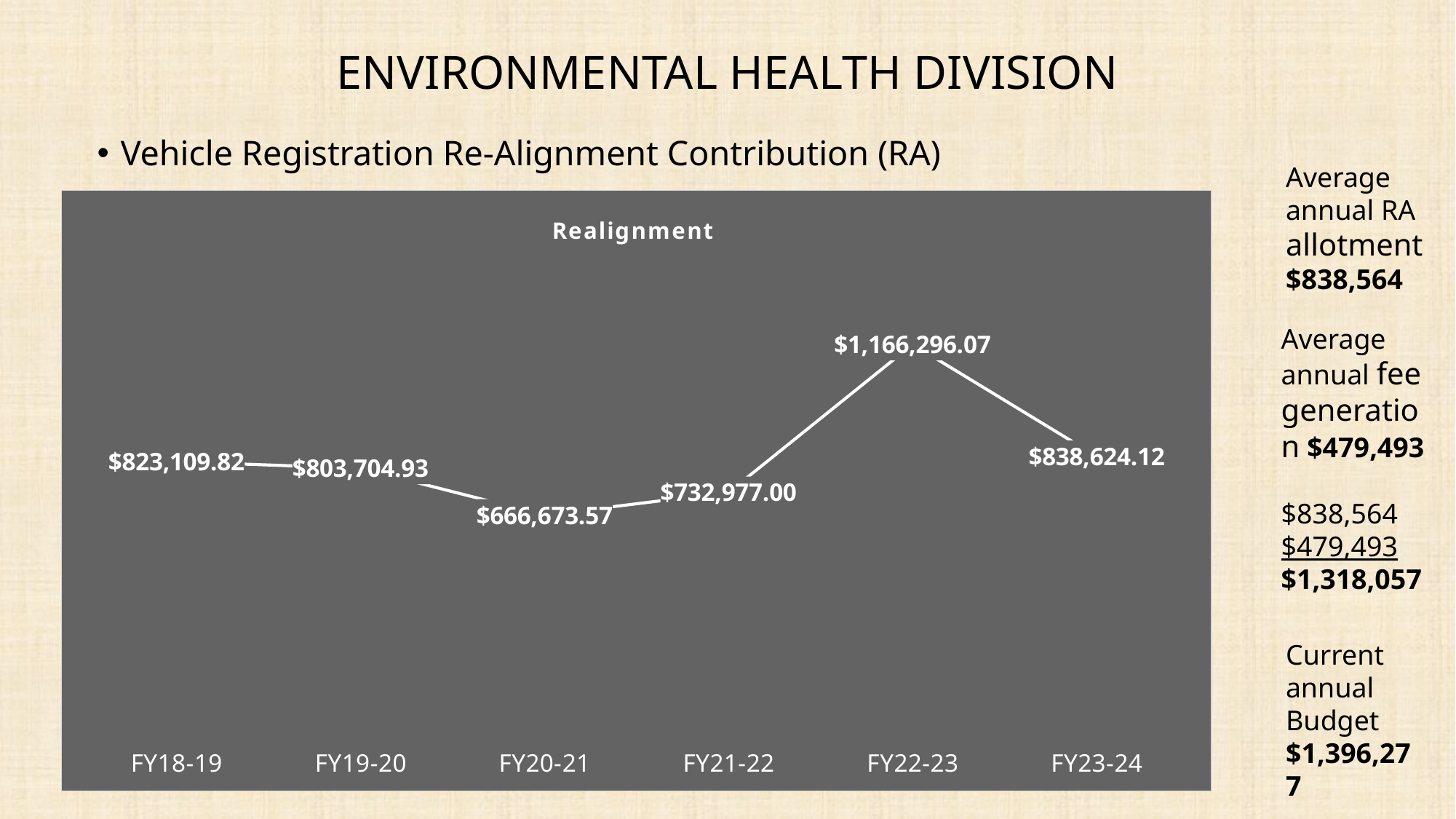
What is the difference between the FY18-19 and FY19-20 values in the Realignment chart? $19,404.89 What is the title of the chart on the slide? Realignment What is the difference between the FY22-23 and FY23-24 values in the Realignment chart? $327,671.95 What is the value for FY18-19 in the Realignment chart? $823,109.82 What is the value for FY20-21 in the Realignment chart? $666,673.57 How many fiscal years are plotted in the Realignment chart? 6 Which fiscal year has the highest value in the Realignment chart? FY22-23 Do the values in the Realignment chart rise or fall from FY18-19 to FY20-21? Fall Which fiscal year has the lowest value in the Realignment chart? FY20-21 What kind of chart is the Realignment chart? Line chart Which is larger in the Realignment chart, the value for FY21-22 or the value for FY20-21? FY21-22 What is the value for FY22-23 in the Realignment chart? $1,166,296.07